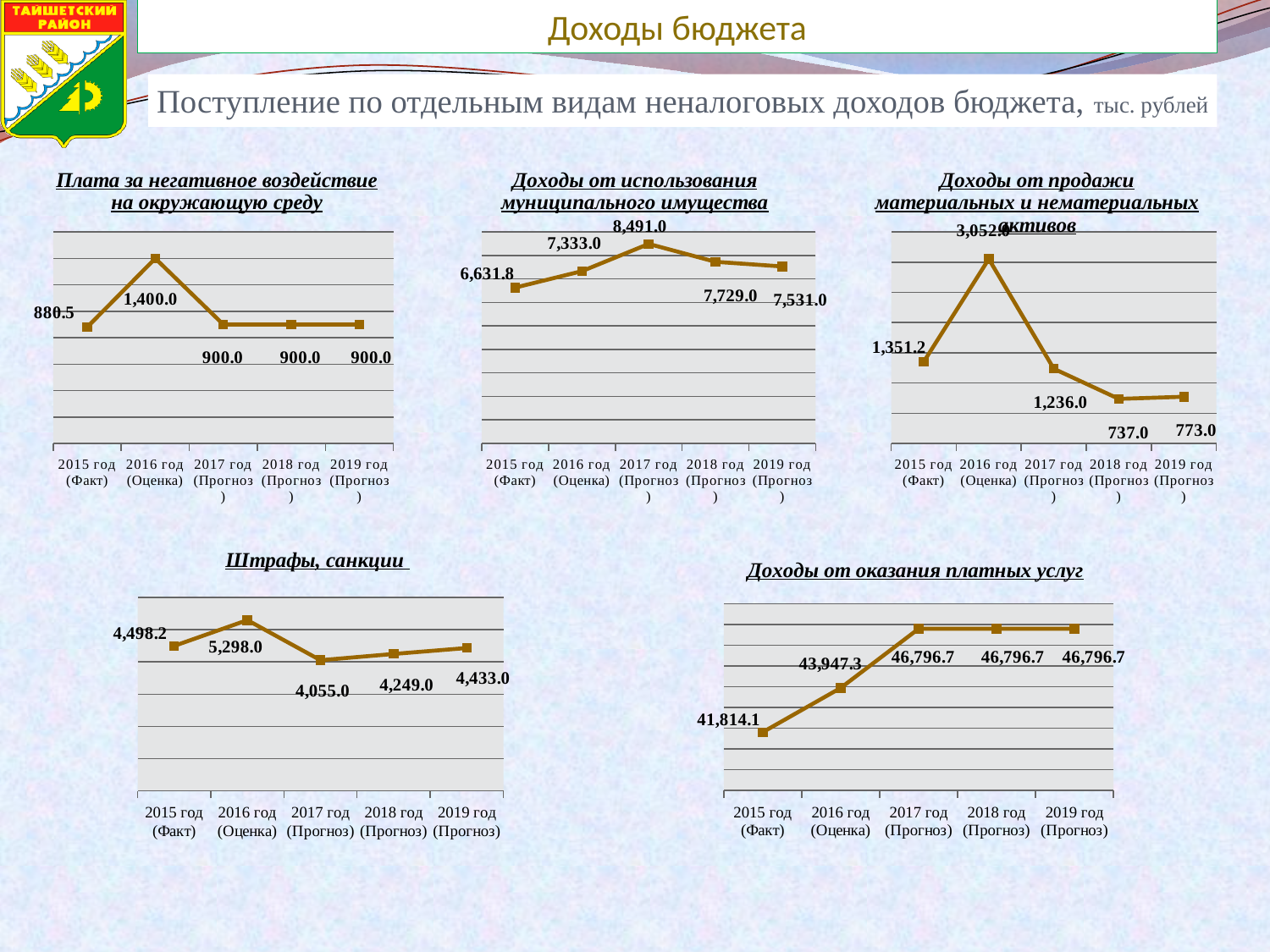
In the chart 'Плата за негативное воздействие на окружающую среду', what is the value for 2016 год (Оценка)? 1,400.0 In the chart 'Штрафы, санкции', what is the value for 2015 год (Факт)? 4,498.2 In the chart 'Доходы от продажи материальных и нематериальных активов', which is larger, the value for 2015 год or the value for 2017 год? 2015 год How many data points are plotted in the chart 'Штрафы, санкции'? 5 In the chart 'Доходы от оказания платных услуг', what is the value for 2019 год (Прогноз)? 46,796.7 In the chart 'Штрафы, санкции', which year has the lowest value? 2017 год (Прогноз) In the chart 'Доходы от использования муниципального имущества', what is the value for 2017 год (Прогноз)? 8,491.0 In the chart 'Доходы от использования муниципального имущества', which year has the lowest value? 2015 год (Факт) In the chart 'Доходы от использования муниципального имущества', what is the difference between the 2017 год value and the 2015 год value? 1,859.2 In the chart 'Плата за негативное воздействие на окружающую среду', which year has the highest value? 2016 год (Оценка) In the chart 'Доходы от продажи материальных и нематериальных активов', what is the value for 2018 год (Прогноз)? 737.0 In the chart 'Доходы от оказания платных услуг', do the values rise or fall from 2015 год to 2017 год? rise